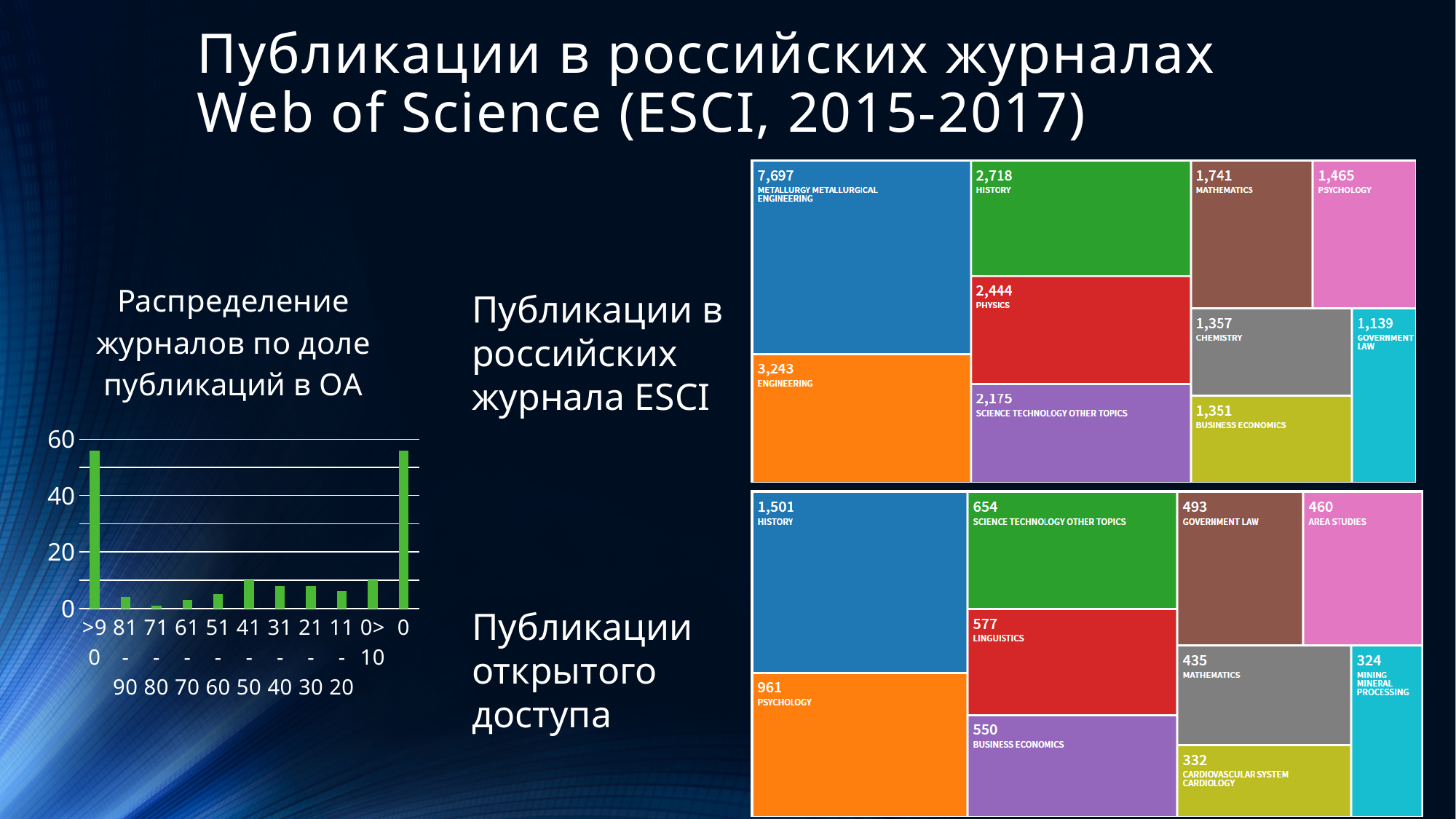
In the treemap titled "Публикации открытого доступа", which is larger: Linguistics or Business Economics? Linguistics In the bar chart titled "Распределение журналов по доле публикаций в OA", how many categories are on the x axis? 11 In the treemap titled "Публикации в российских журнала ESCI", which is larger: History or Physics? History In the treemap titled "Публикации в российских журнала ESCI", how many categories are shown? 10 What kind of chart is the chart titled "Распределение журналов по доле публикаций в OA"? bar chart In the treemap titled "Публикации открытого доступа", what is the difference between History and Psychology? 540 In the treemap titled "Публикации в российских журнала ESCI", how many publications are shown for Metallurgy Metallurgical Engineering? 7,697 In the treemap titled "Публикации открытого доступа", which category has the highest value? History In the treemap titled "Публикации открытого доступа", what is the value for Psychology? 961 In the treemap titled "Публикации в российских журнала ESCI", what is the difference between Metallurgy Metallurgical Engineering and Engineering? 4,454 In the bar chart titled "Распределение журналов по доле публикаций в OA", is the value for the ">90" category greater or less than 40? greater In the treemap titled "Публикации в российских журнала ESCI", which category has the lowest value? Government Law